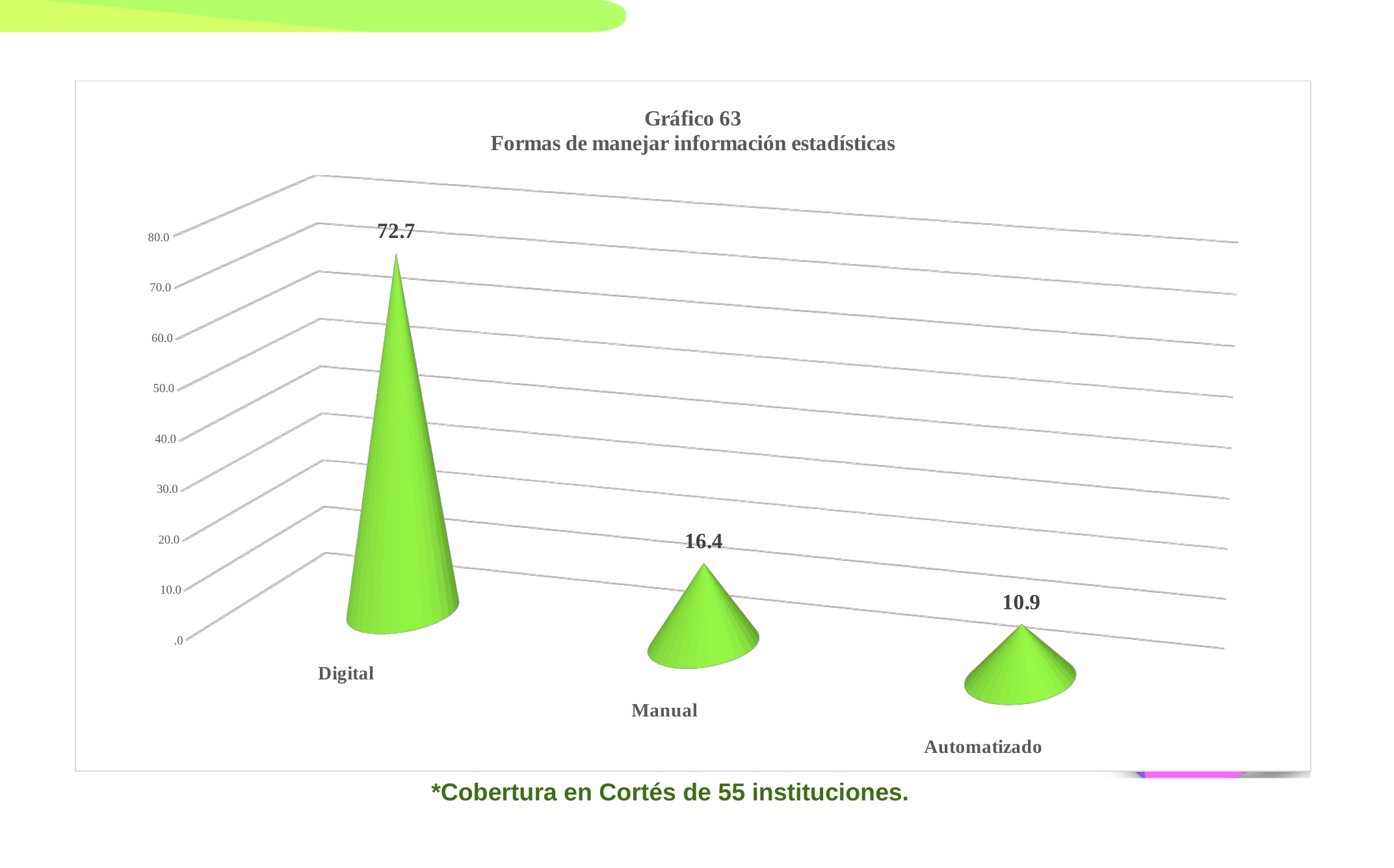
What is the value for Manual? 16.4 What is the title of the chart? Gráfico 63 Formas de manejar información estadísticas What kind of chart is shown on the slide? bar chart Is the value for Digital greater or less than 70.0? greater What is the difference between the values for Digital and Manual? 56.3 What is the value for Digital? 72.7 Which category has the lowest value? Automatizado What is the value for Automatizado? 10.9 Which category has the highest value? Digital Which is larger, the value for Manual or the value for Automatizado? Manual What is the difference between the values for Manual and Automatizado? 5.5 How many categories are shown in the chart? 3